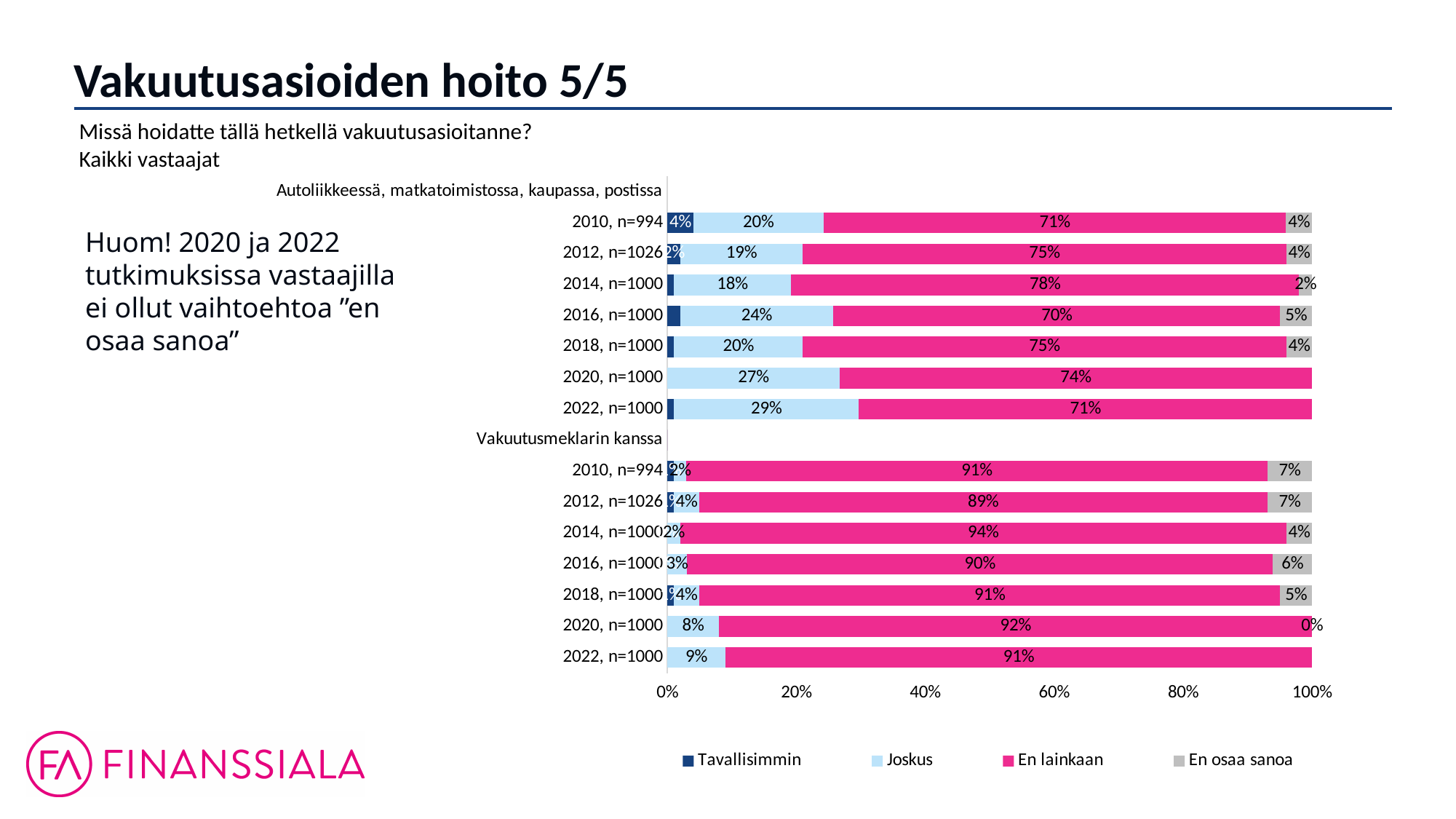
In the Autoliikkeessä, matkatoimistossa, kaupassa, postissa group, which year has the lowest 'Joskus' value? 2014, n=1000 In the Autoliikkeessä, matkatoimistossa, kaupassa, postissa group, which year has the highest 'Joskus' value? 2022, n=1000 In the Autoliikkeessä, matkatoimistossa, kaupassa, postissa group, what is the 'Joskus' value for 2022, n=1000? 29% In the Vakuutusmeklarin kanssa group, what is the 'Joskus' value for 2020, n=1000? 8% How many series does the legend list? 4 What kind of chart is shown on the slide? Stacked bar chart In the Autoliikkeessä, matkatoimistossa, kaupassa, postissa group, what is the difference between the 'En lainkaan' values for 2014, n=1000 and 2016, n=1000? 8 percentage points In the Autoliikkeessä, matkatoimistossa, kaupassa, postissa group, what is the 'En lainkaan' value for 2014, n=1000? 78% In the Vakuutusmeklarin kanssa group, what is the 'En osaa sanoa' value for 2010, n=994? 7% In the Vakuutusmeklarin kanssa group, what is the 'En lainkaan' value for 2014, n=1000? 94% How many bars are plotted in the chart in total? 14 In the Vakuutusmeklarin kanssa group, is the 'En lainkaan' value for 2012, n=1026 larger or smaller than for 2014, n=1000? Smaller